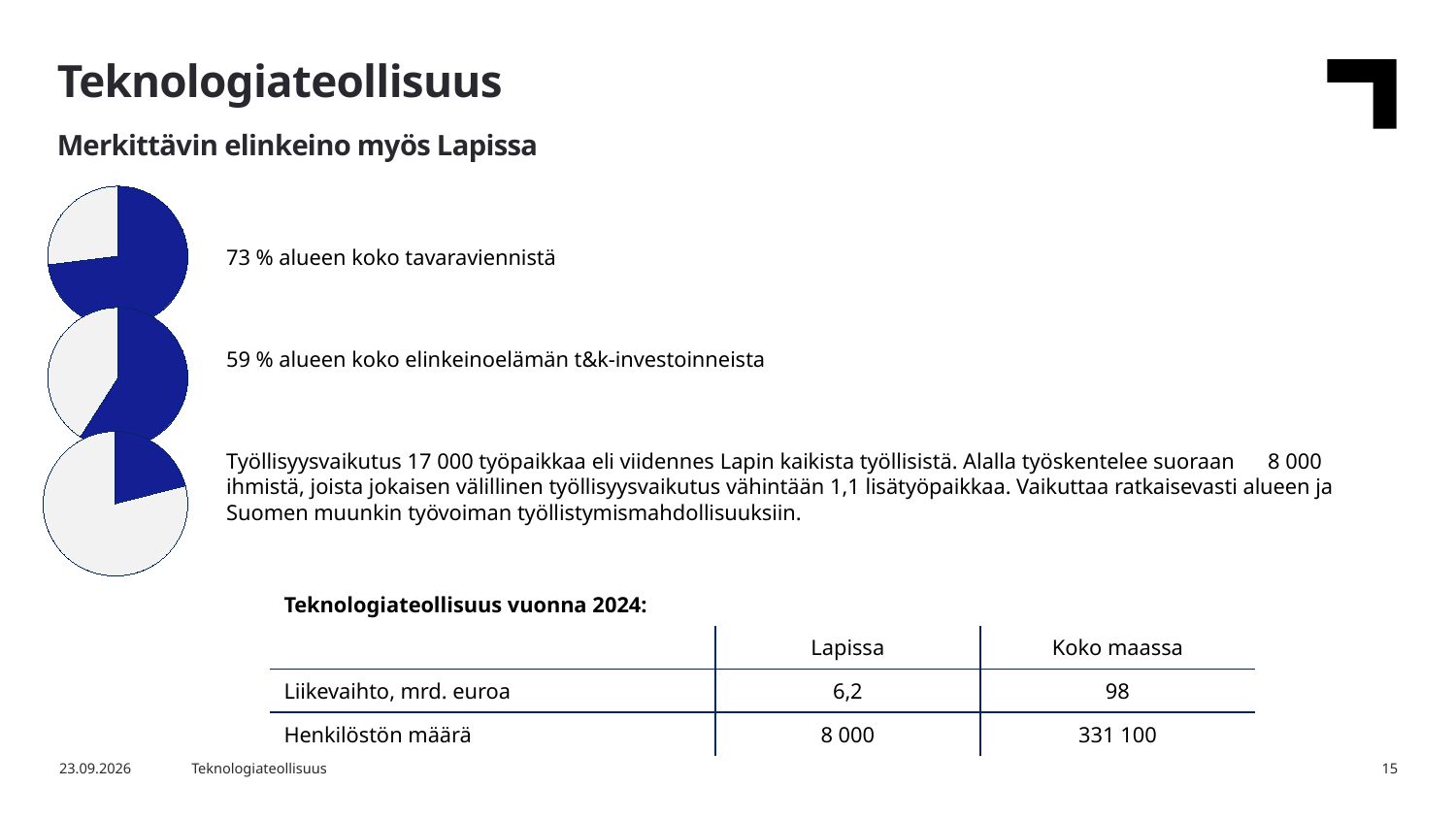
Which pie chart has the smallest blue slice: the top, middle or bottom one? Bottom What colour is the larger slice in the top pie chart? Dark blue What kind of chart is the top chart on the left of the slide? Pie chart What is the difference between the shares shown for the top pie chart (73 %) and the middle pie chart (59 %)? 14 percentage points In the middle pie chart, what share does the blue slice represent according to the text beside it? 59 % How many slices does the top pie chart have? 2 In the top pie chart, what share does the blue slice represent according to the text beside it? 73 % Which pie chart has the largest blue slice: the top, middle or bottom one? Top How many pie charts are shown on the slide? 3 Is the blue slice larger in the top pie chart or in the middle pie chart? Top Is the blue slice in the bottom pie chart greater or less than half of the pie? Less What does the top pie chart represent, according to the text next to it? Share of the region's total goods exports (alueen koko tavaraviennistä)